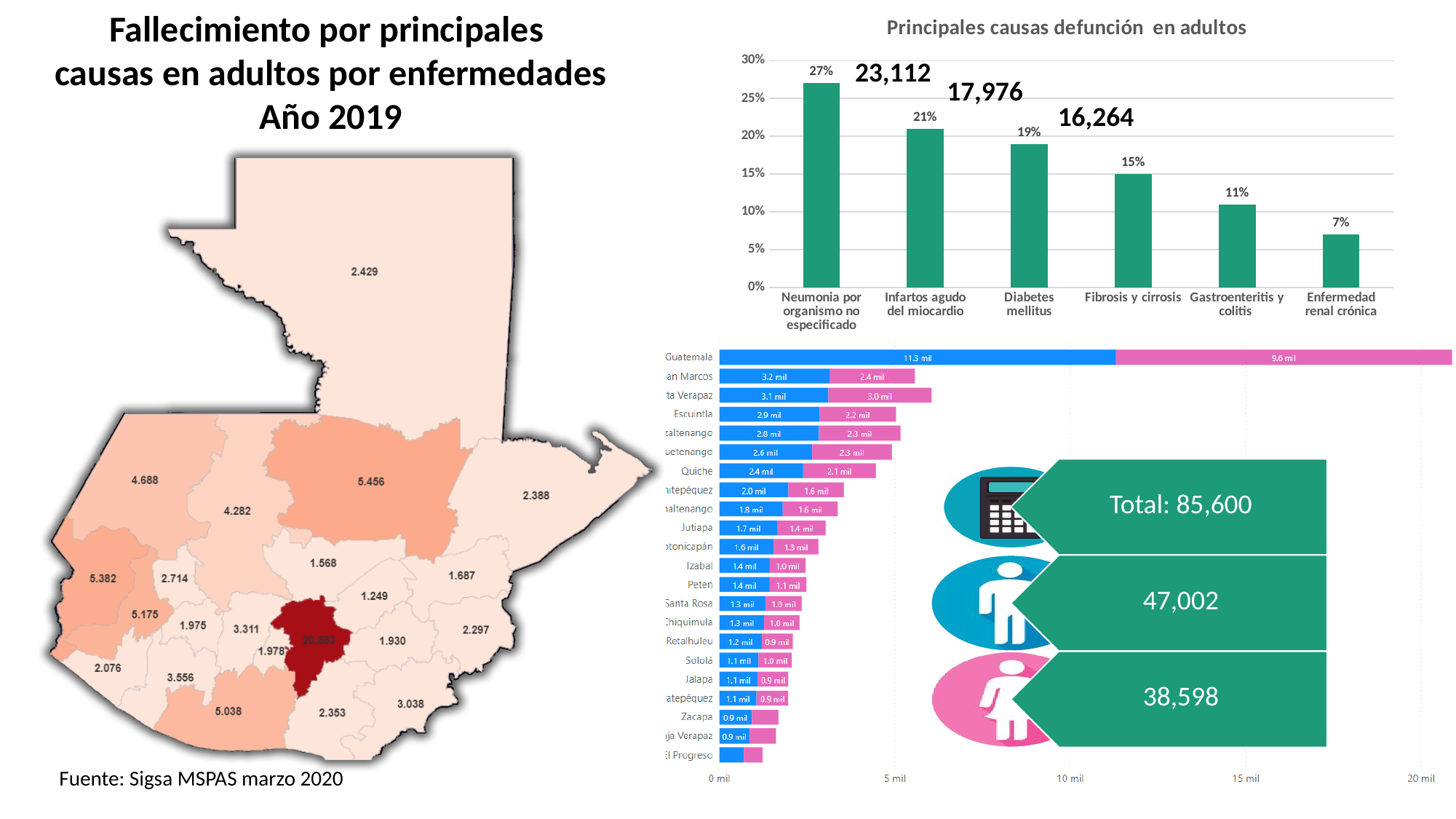
In the chart 'Principales causas defunción en adultos', do the values rise or fall from left to right? Fall In the horizontal stacked bar chart by department at the bottom right, what is the blue value for Guatemala? 11.3 mil In the chart 'Principales causas defunción en adultos', what percentage is shown for Diabetes mellitus? 19% In the chart 'Principales causas defunción en adultos', how many causes are plotted? 6 What kind of chart is 'Principales causas defunción en adultos'? Bar chart In the horizontal stacked bar chart by department at the bottom right, which department has the longest bar? Guatemala In the chart 'Principales causas defunción en adultos', what percentage is shown for Fibrosis y cirrosis? 15% In the chart 'Principales causas defunción en adultos', which cause has the lowest percentage? Enfermedad renal crónica In the horizontal stacked bar chart by department at the bottom right, is the total bar for Guatemala greater or less than 20 mil? greater In the horizontal stacked bar chart by department at the bottom right, what is the pink value for Escuintla? 2.2 mil In the chart 'Principales causas defunción en adultos', what is the difference in percentage points between Infartos agudo del miocardio and Gastroenteritis y colitis? 10 In the chart 'Principales causas defunción en adultos', which cause has the highest percentage? Neumonia por organismo no especificado